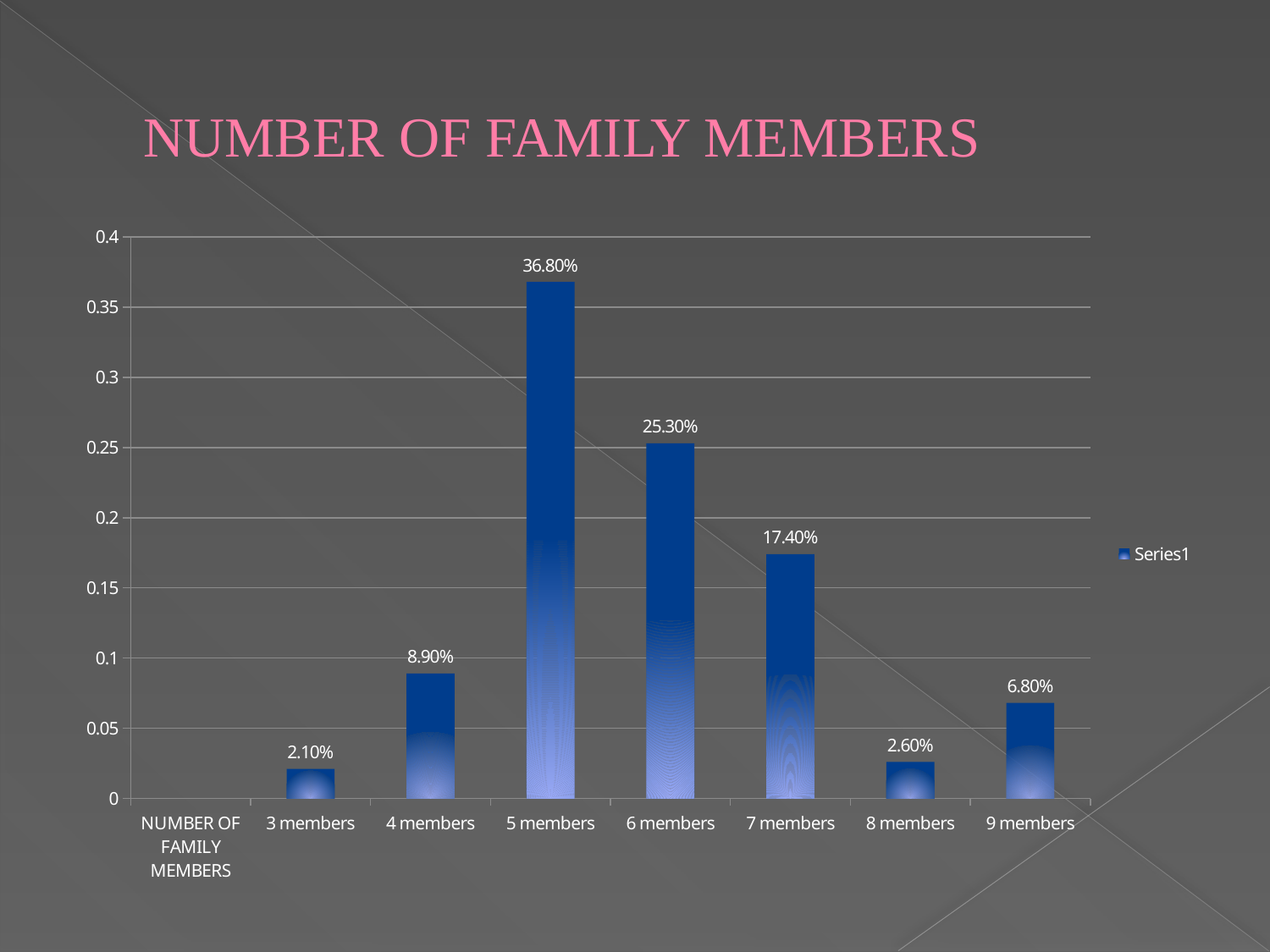
Which is larger, the value for 4 members or the value for 9 members? 4 members What is the value for 5 members? 36.80% Which category has the lowest value? 3 members What is the difference between the values for 5 members and 6 members? 11.50% What is the difference between the values for 7 members and 8 members? 14.80% What is the value for 9 members? 6.80% What type of chart is shown on the slide? bar chart What is the value for 7 members? 17.40% Which category has the highest value? 5 members How many bars are plotted in the chart? 7 What is the name of the series listed in the legend? Series1 Is the value for 6 members greater or less than 0.2? greater